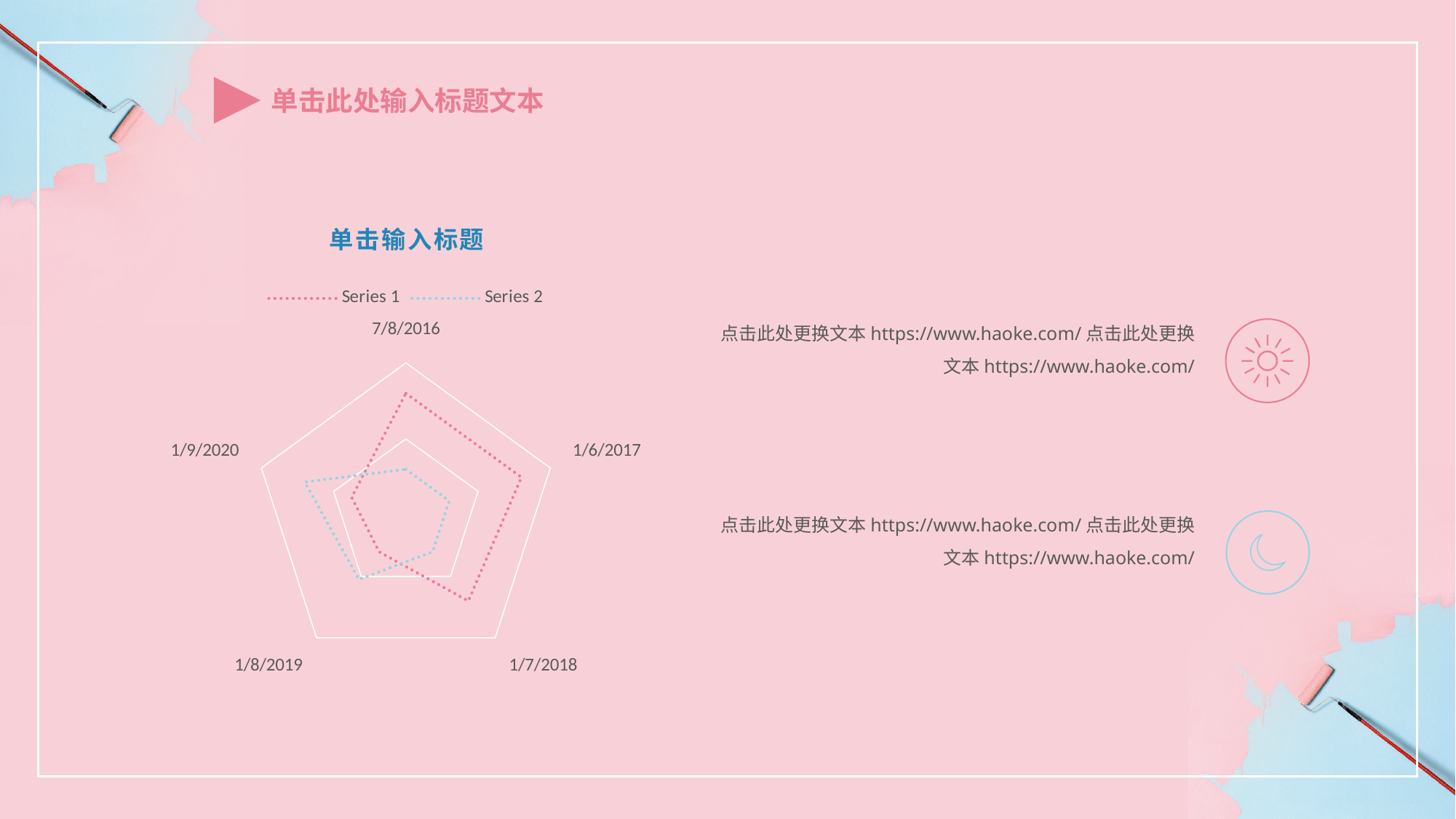
What is the title of the chart? 单击输入标题 At 1/7/2018, which series has the larger value, Series 1 or Series 2? Series 1 How many categories (axes) does the radar chart have? 5 For Series 2, which category has the highest value? 1/9/2020 At 1/6/2017, which series has the larger value, Series 1 or Series 2? Series 1 What are the names of the two series in the legend? Series 1 and Series 2 At 7/8/2016, which series has the larger value, Series 1 or Series 2? Series 1 What kind of chart is shown on the slide? Radar chart How many series does the chart legend list? 2